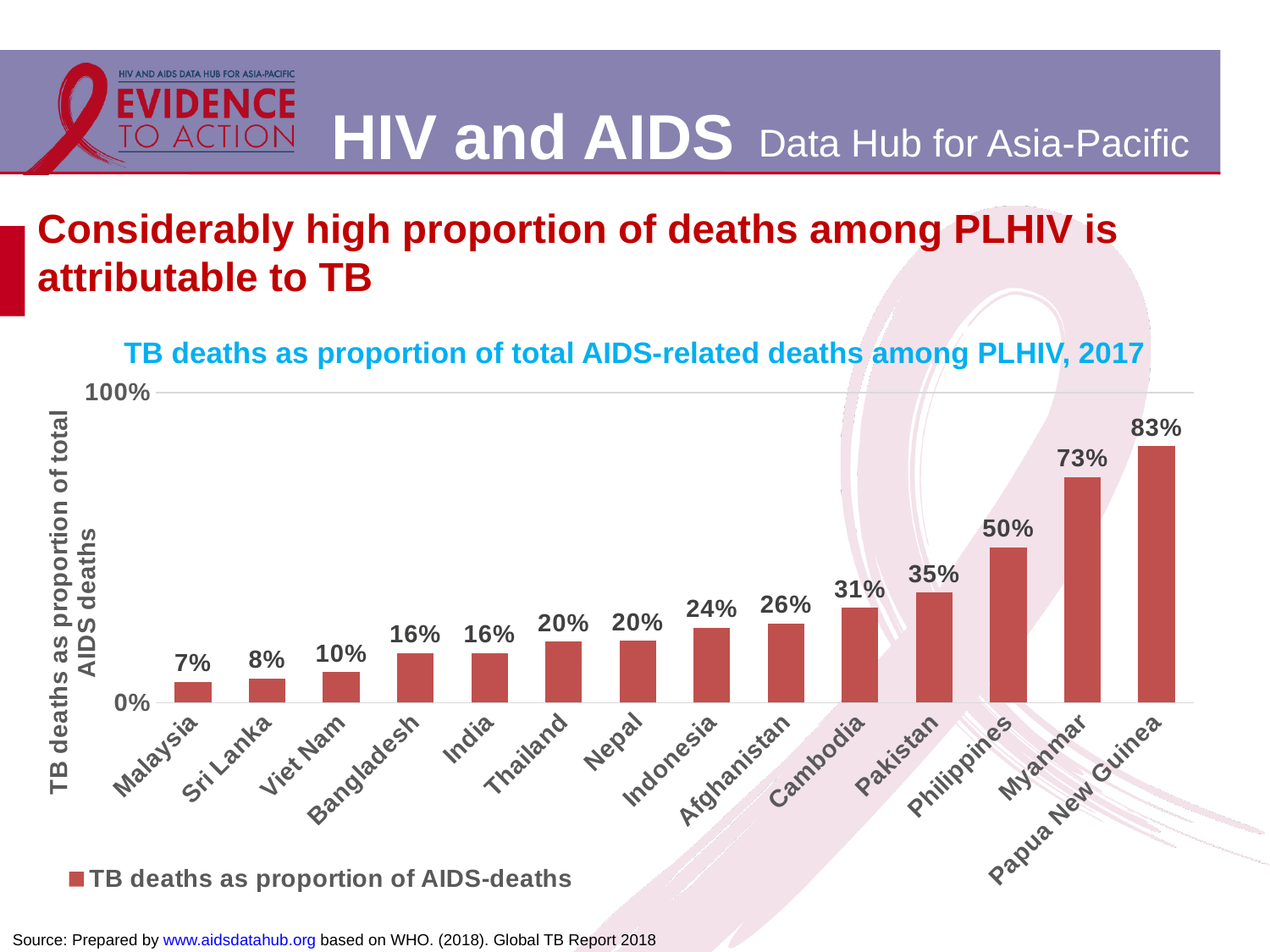
What kind of chart is shown on the slide? Bar chart How many series does the legend list? 1 What is the title of the chart? TB deaths as proportion of total AIDS-related deaths among PLHIV, 2017 What is the value for Papua New Guinea? 83% Which is larger, the value for Pakistan or the value for Afghanistan? Pakistan Which country has the highest TB deaths as proportion of AIDS-deaths? Papua New Guinea What is the value for Cambodia? 31% Do the values rise or fall from left to right along the x axis? Rise How many countries are shown on the chart? 14 Which country has the lowest TB deaths as proportion of AIDS-deaths? Malaysia What is the value for Viet Nam? 10% What is the difference between the values for Myanmar and Philippines? 23%